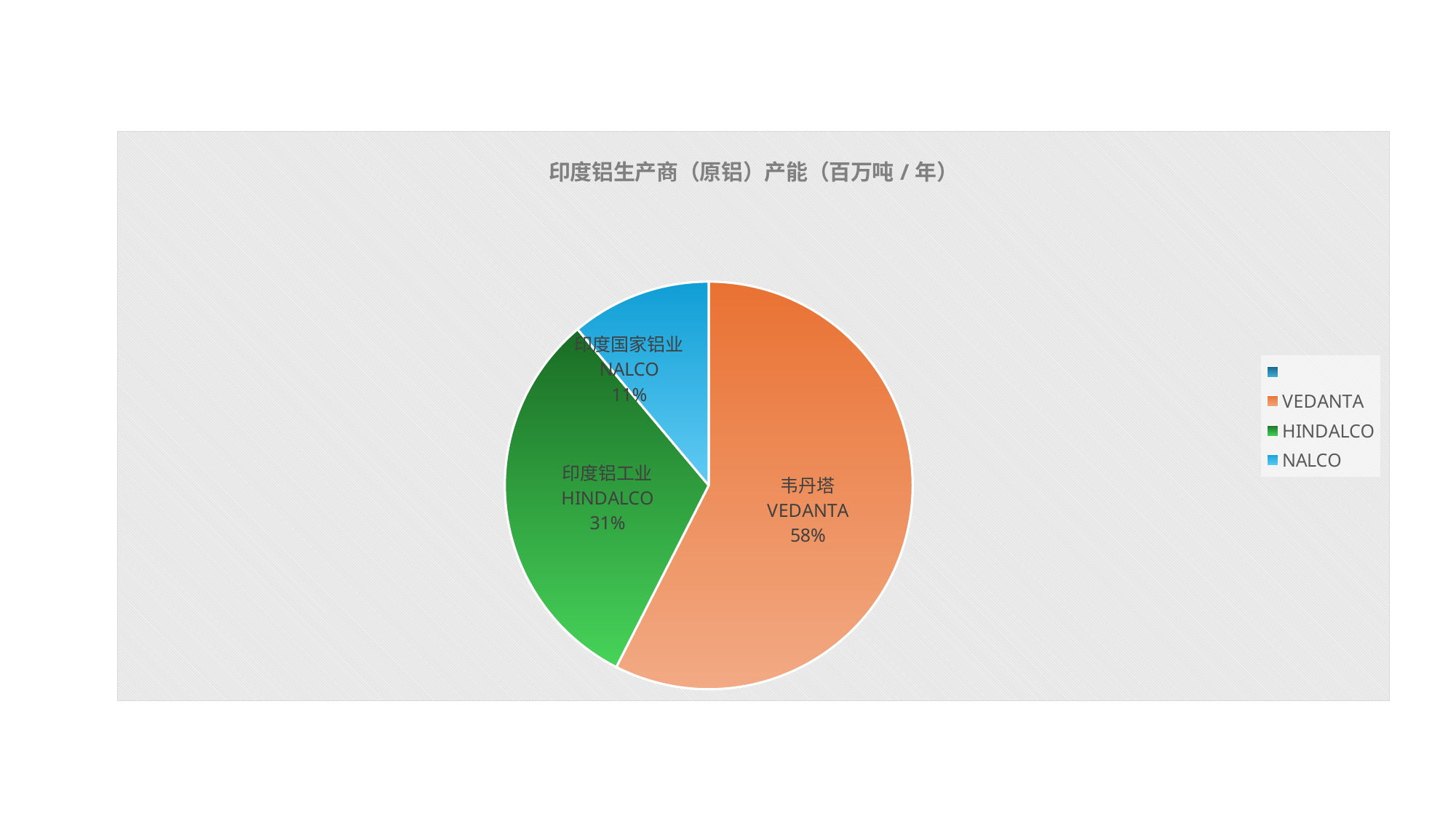
What colour is the VEDANTA slice? orange Which producer has the largest slice of the pie? VEDANTA How many slices does the pie chart have? 3 What share of the pie does HINDALCO (印度铝工业) hold? 31% By how many percentage points does HINDALCO's share exceed NALCO's share? 20 percentage points What share of the pie does VEDANTA (韦丹塔) hold? 58% What share of the pie does NALCO (印度国家铝业) hold? 11% Which producer has the smallest slice of the pie? NALCO Which has a larger share, HINDALCO or NALCO? HINDALCO By how many percentage points does VEDANTA's share exceed HINDALCO's share? 27 percentage points What is the title of the chart? 印度铝生产商（原铝）产能（百万吨 / 年） What kind of chart is shown on the slide? pie chart